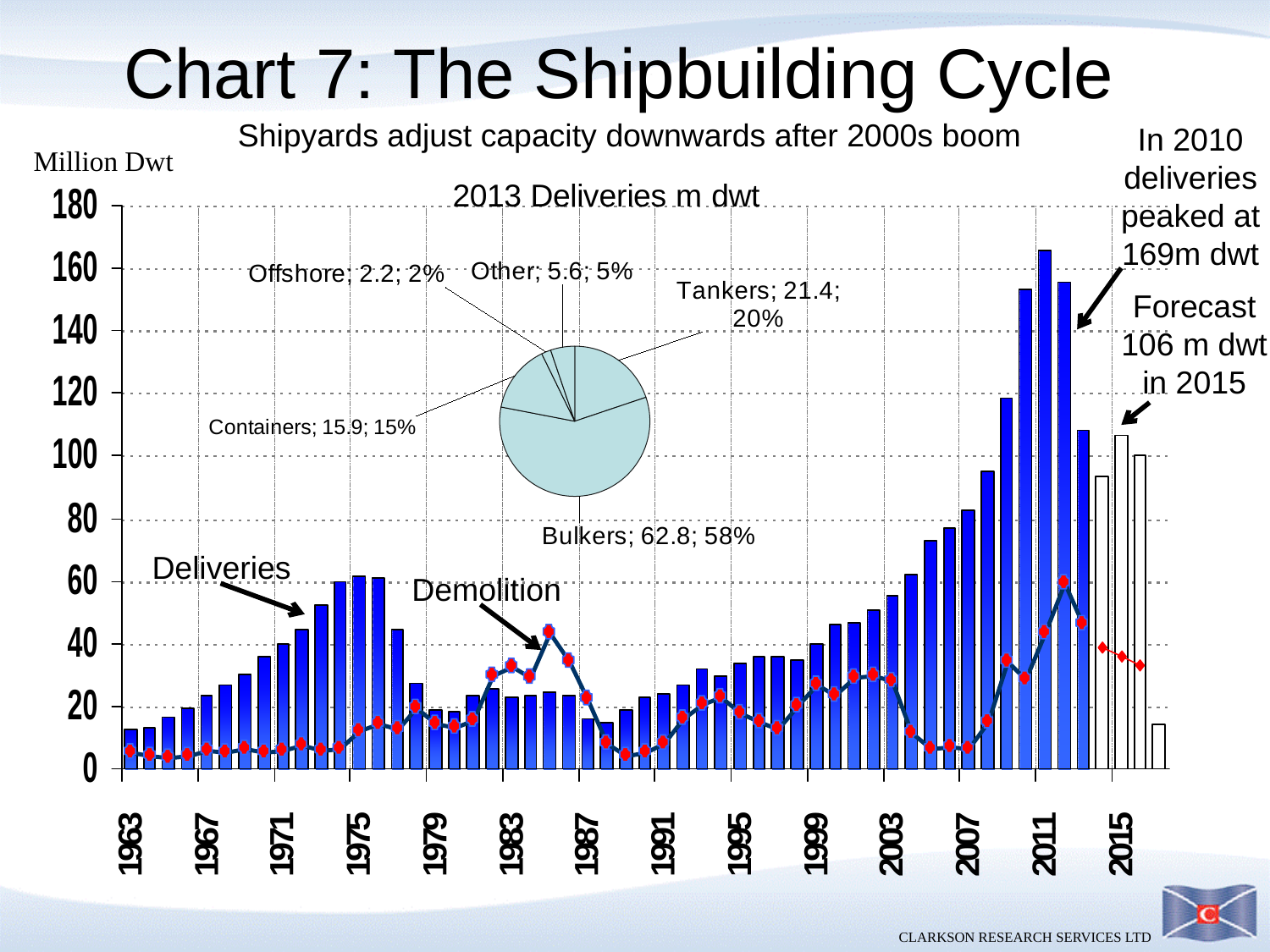
In the main chart, is the Deliveries value for 2011 greater or less than 140? greater In the pie chart titled '2013 Deliveries m dwt', which category has the largest slice? Bulkers In the pie chart titled '2013 Deliveries m dwt', what is the difference between the Bulkers value and the Tankers value? 41.4 In the main chart, at what level did deliveries peak in 2010 according to the annotation? 169m dwt In the main chart, what is the forecast deliveries value for 2015 according to the annotation? 106 m dwt In the pie chart titled '2013 Deliveries m dwt', what is the value for Bulkers? 62.8 In the main chart, is the Deliveries value for 1963 greater or less than 20? less In the pie chart titled '2013 Deliveries m dwt', what share of the pie do Tankers represent? 20% In the main chart, what kind of chart is used to show Deliveries? bar chart In the pie chart titled '2013 Deliveries m dwt', what is the value for Containers? 15.9 In the pie chart titled '2013 Deliveries m dwt', which category has the smallest slice? Offshore How many slices does the pie chart titled '2013 Deliveries m dwt' have? 5